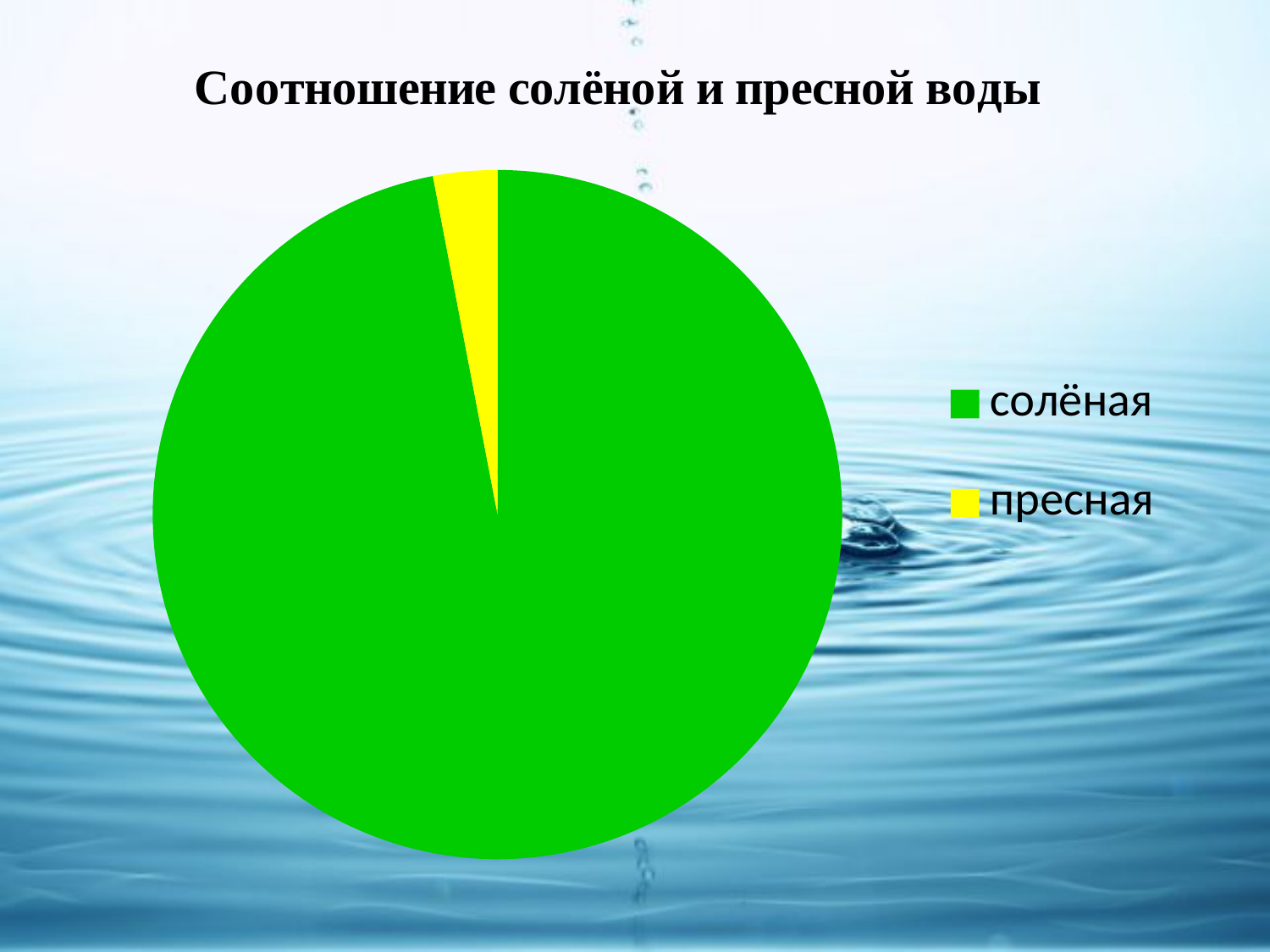
What kind of chart is shown on the slide? pie chart What colour represents пресная in the pie chart? yellow What is the title of the chart? Соотношение солёной и пресной воды Which category has the smallest slice of the pie? пресная How many slices does the pie chart have? 2 Which category has the largest slice of the pie? солёная Which slice is larger, солёная or пресная? солёная How many entries does the legend list? 2